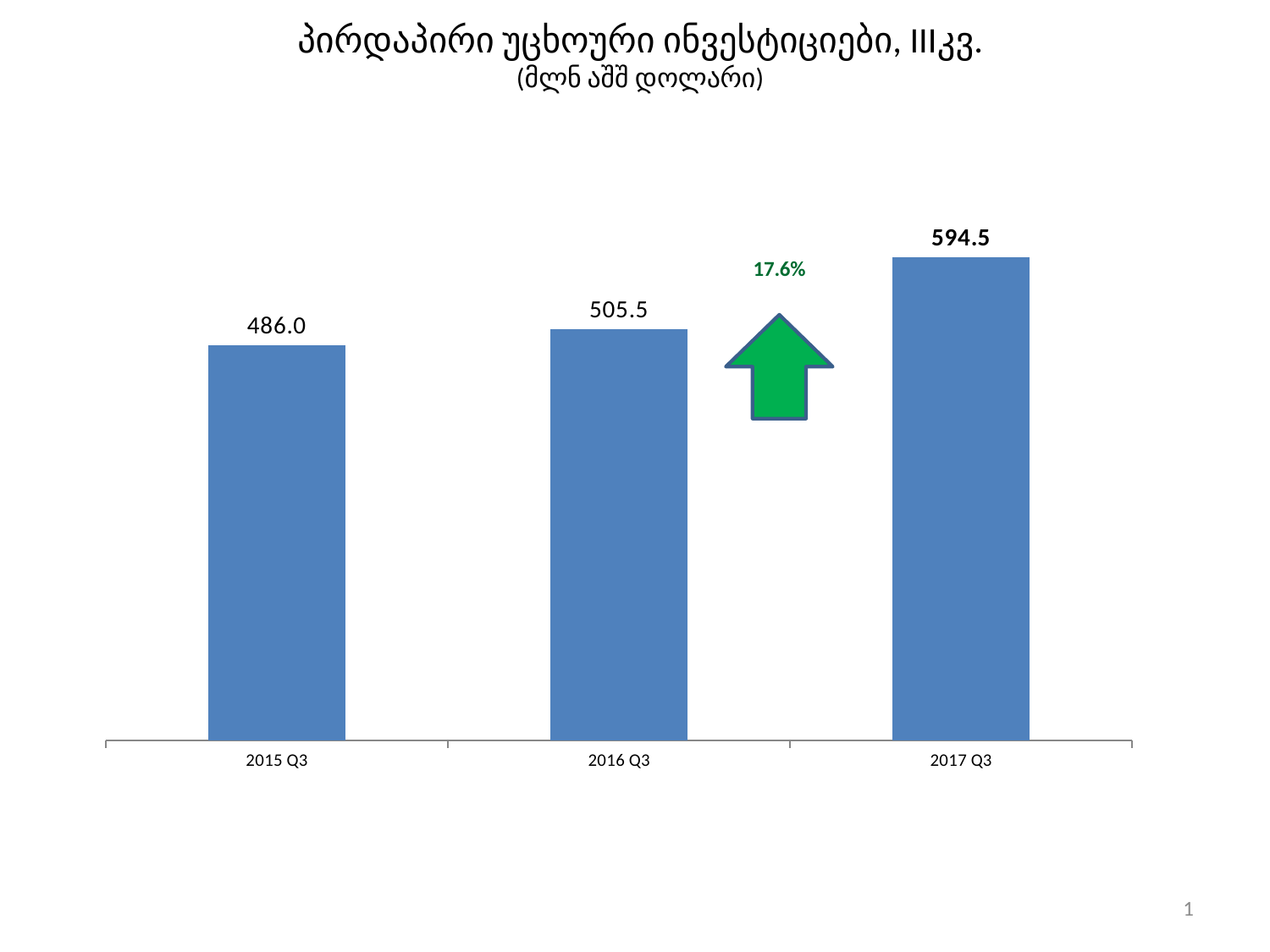
What is the value for 2016 Q3? 505.5 How many periods are shown on the x axis? 3 What is the value for 2017 Q3? 594.5 Which period has the lowest value? 2015 Q3 What is the difference between the values for 2016 Q3 and 2015 Q3? 19.5 What is the value for 2015 Q3? 486.0 What is the difference between the values for 2017 Q3 and 2016 Q3? 89.0 What kind of chart is this? bar chart What percentage change is shown next to the green arrow? 17.6% Which is larger, the value for 2016 Q3 or the value for 2017 Q3? 2017 Q3 Which period has the highest value? 2017 Q3 Do the values rise or fall from 2015 Q3 to 2017 Q3? rise